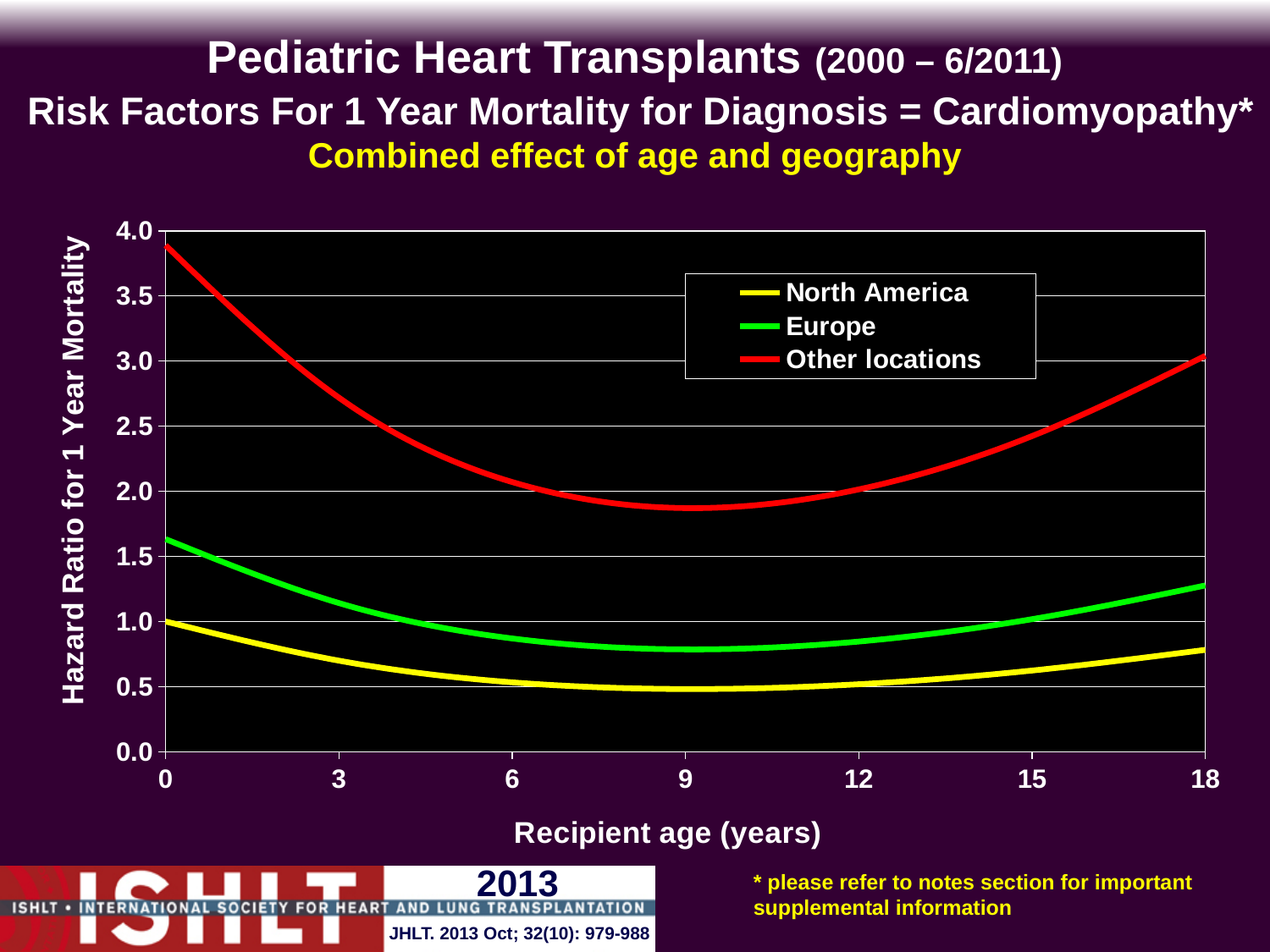
Is the hazard ratio for Europe at recipient age 0 greater or less than 1.5? greater At recipient age 9, which series has the larger hazard ratio, Europe or Other locations? Other locations Is the hazard ratio for Other locations at recipient age 9 greater or less than 2.0? less What kind of chart is shown on the slide? Line chart Is the hazard ratio for North America at recipient age 18 greater or less than 1.0? less Does the hazard ratio for Other locations rise or fall as recipient age increases from 0 to 9 years? Fall Which series has the highest hazard ratio across all recipient ages? Other locations How many series does the legend list? 3 What colour is the line for Europe? Green Which series has the lowest hazard ratio across all recipient ages? North America What is the label of the x axis? Recipient age (years)